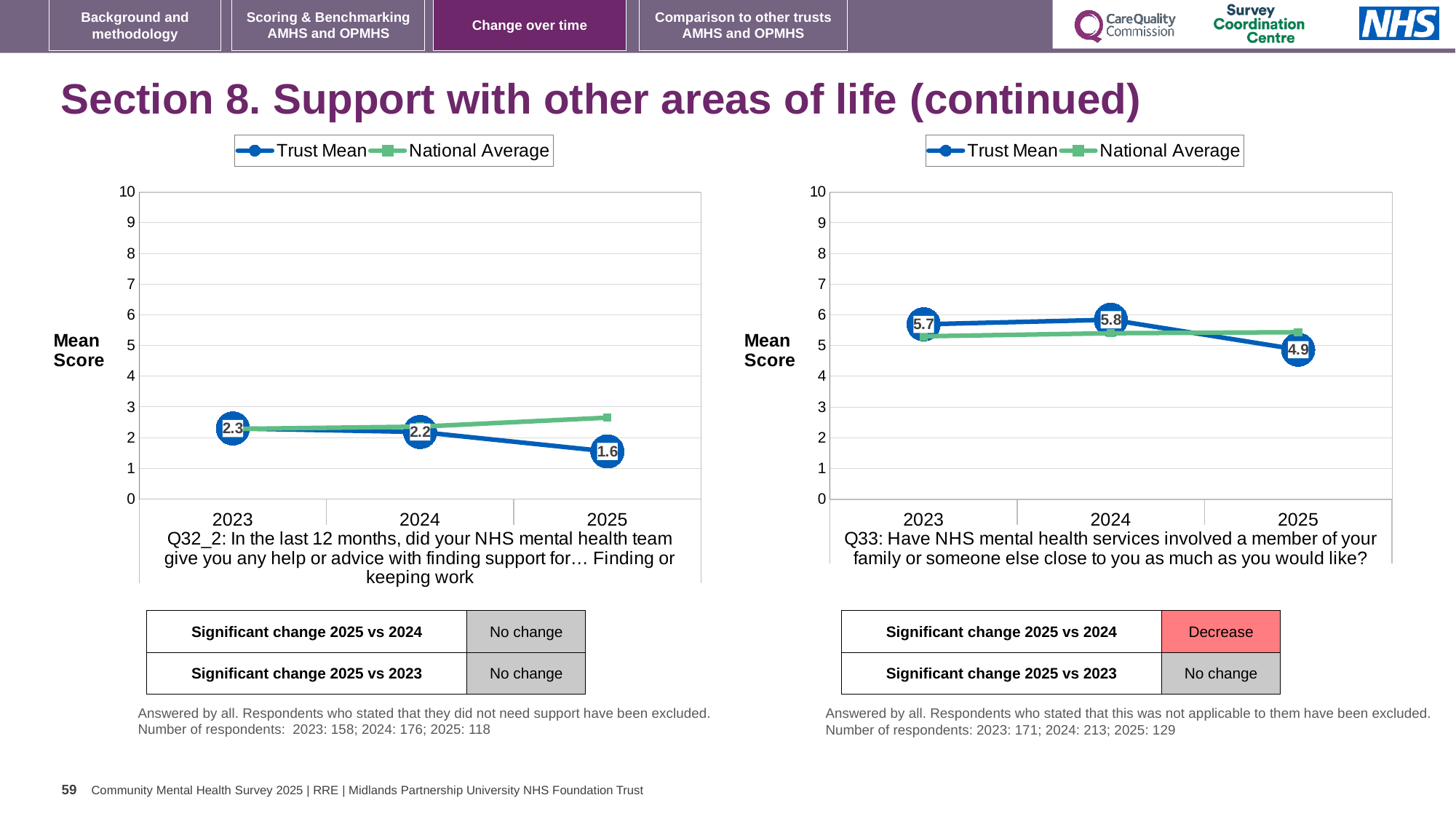
In the left chart (Q32_2), is the National Average for 2025 greater or less than 2? greater In the right chart (Q33), is the Trust Mean for 2025 greater or less than the National Average for 2025? less In the left chart (Q32_2), what is the difference between the Trust Mean for 2023 and 2025? 0.7 In the right chart (Q33), which year has the lowest Trust Mean? 2025 What kind of chart is the left chart (Q32_2)? Line chart In the left chart (Q32_2), what is the Trust Mean for 2025? 1.6 How many series does the legend of the right chart (Q33) list? 2 In the right chart (Q33), what is the difference between the Trust Mean for 2024 and 2025? 0.9 In the left chart (Q32_2), what is the Trust Mean for 2023? 2.3 In the right chart (Q33), what is the Trust Mean for 2024? 5.8 In the right chart (Q33), what is the Trust Mean for 2025? 4.9 In the left chart (Q32_2), which year has the highest Trust Mean? 2023